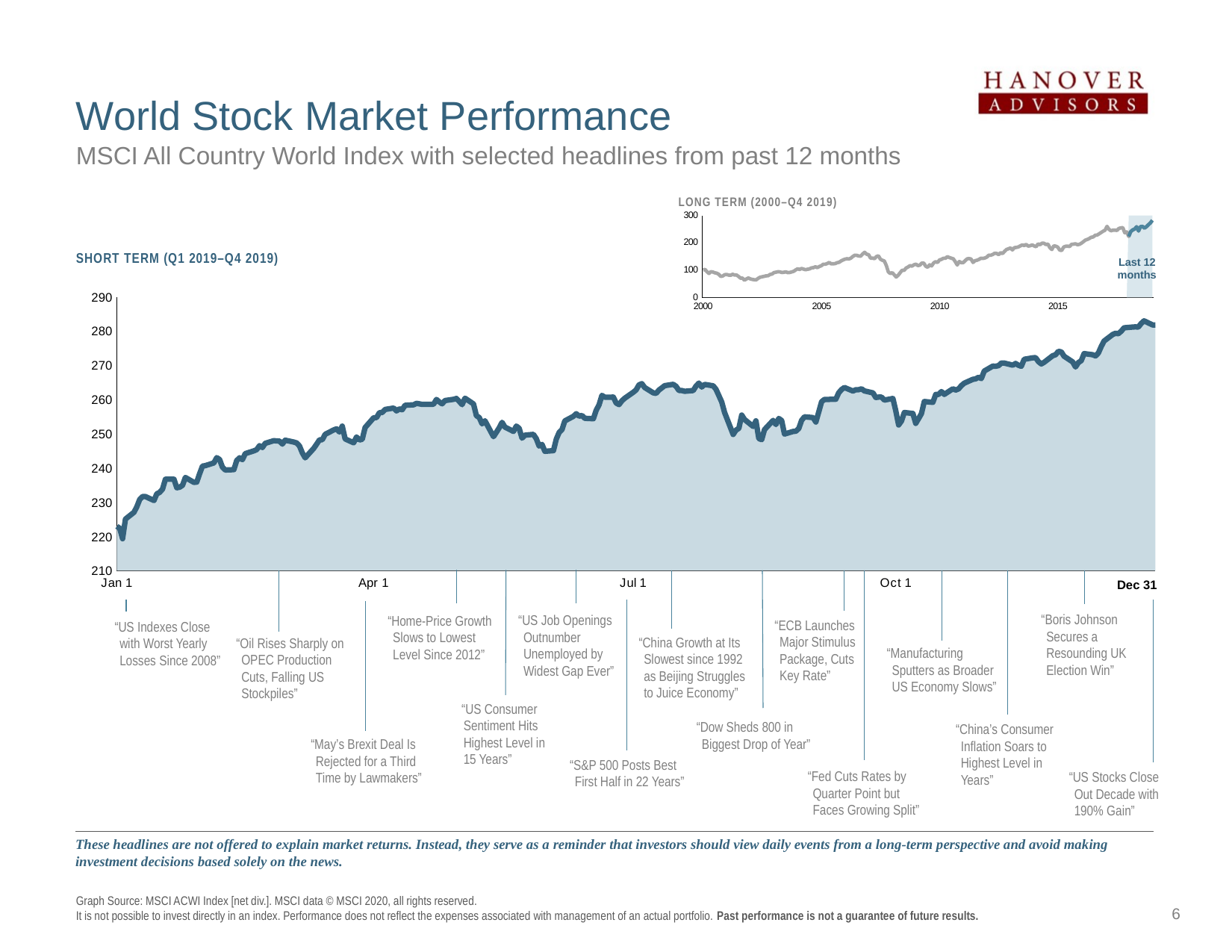
What kind of chart is the Short Term (Q1 2019–Q4 2019) chart? line chart In the Short Term (Q1 2019–Q4 2019) chart, is the value at Jan 1 greater or less than 230? less In the Short Term (Q1 2019–Q4 2019) chart, which is larger, the value at Jan 1 or the value at Dec 31? Dec 31 In the Short Term (Q1 2019–Q4 2019) chart, is the value at Dec 31 greater or less than 270? greater What kind of chart is the Long Term (2000–Q4 2019) chart? line chart In the Short Term (Q1 2019–Q4 2019) chart, which is larger, the value at Oct 1 or the value at Dec 31? Dec 31 In the Short Term (Q1 2019–Q4 2019) chart, is the value at Apr 1 greater or less than 240? greater In the Long Term (2000–Q4 2019) chart, do values overall rise or fall from 2000 to the end of the series? rise What label is given to the shaded region at the right end of the Long Term (2000–Q4 2019) chart? Last 12 months In the Short Term (Q1 2019–Q4 2019) chart, do values overall rise or fall from Jan 1 to Dec 31? rise